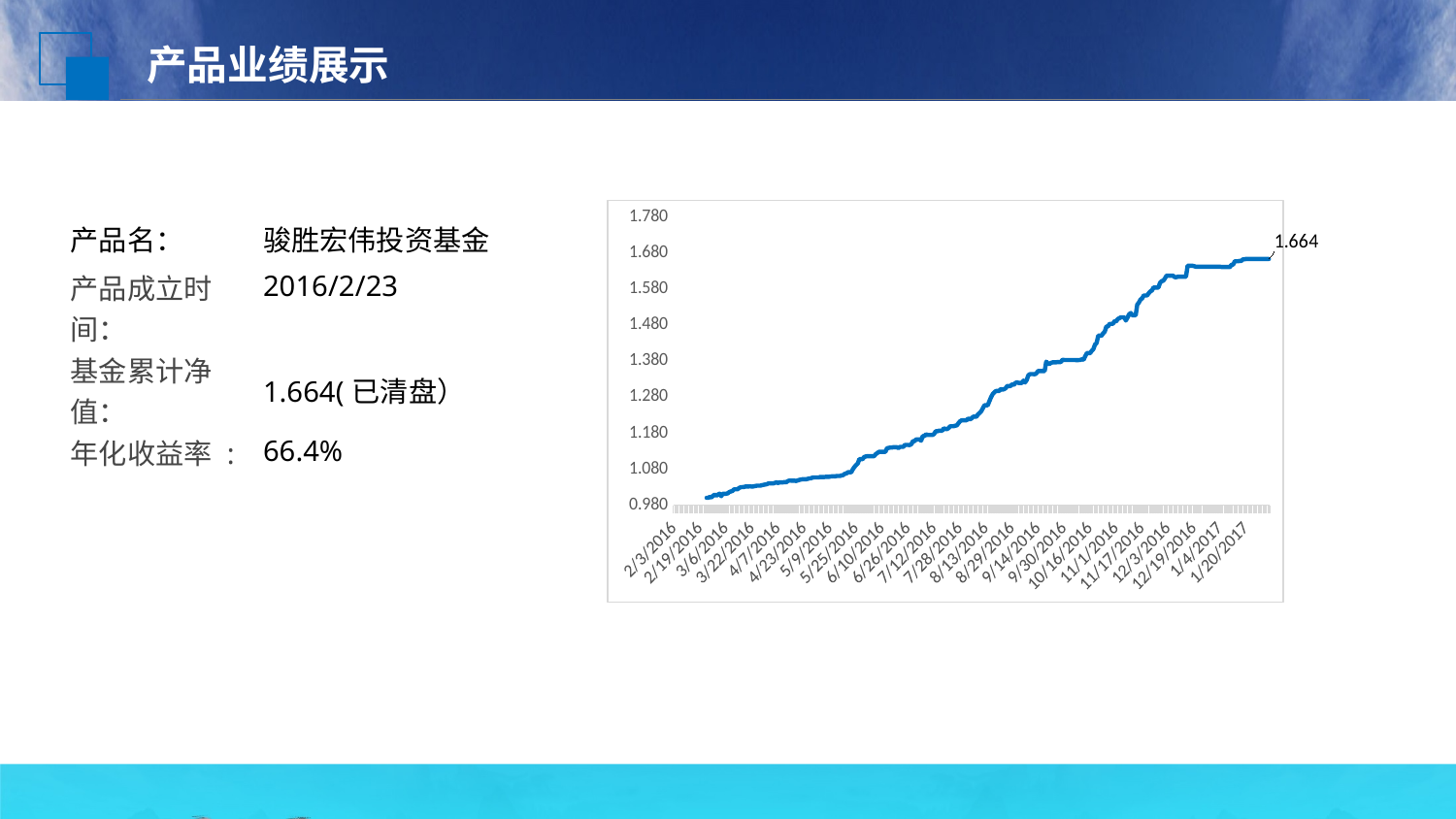
Is the value around 4/7/2016 greater or less than 1.080? less Is the value at 1/20/2017 greater or less than 1.580? greater Is the value around 7/12/2016 greater or less than 1.280? less What is the value shown by the data label at the end of the line? 1.664 What kind of chart is shown on the slide? line chart Do the values on the chart generally rise or fall from left to right along the x axis? rise Which is larger, the value around 2/19/2016 or the value around 11/1/2016? 11/1/2016 What is the lowest tick value shown on the y axis? 0.980 What is the first date label shown on the x axis? 2/3/2016 What is the highest value labelled on the line? 1.664